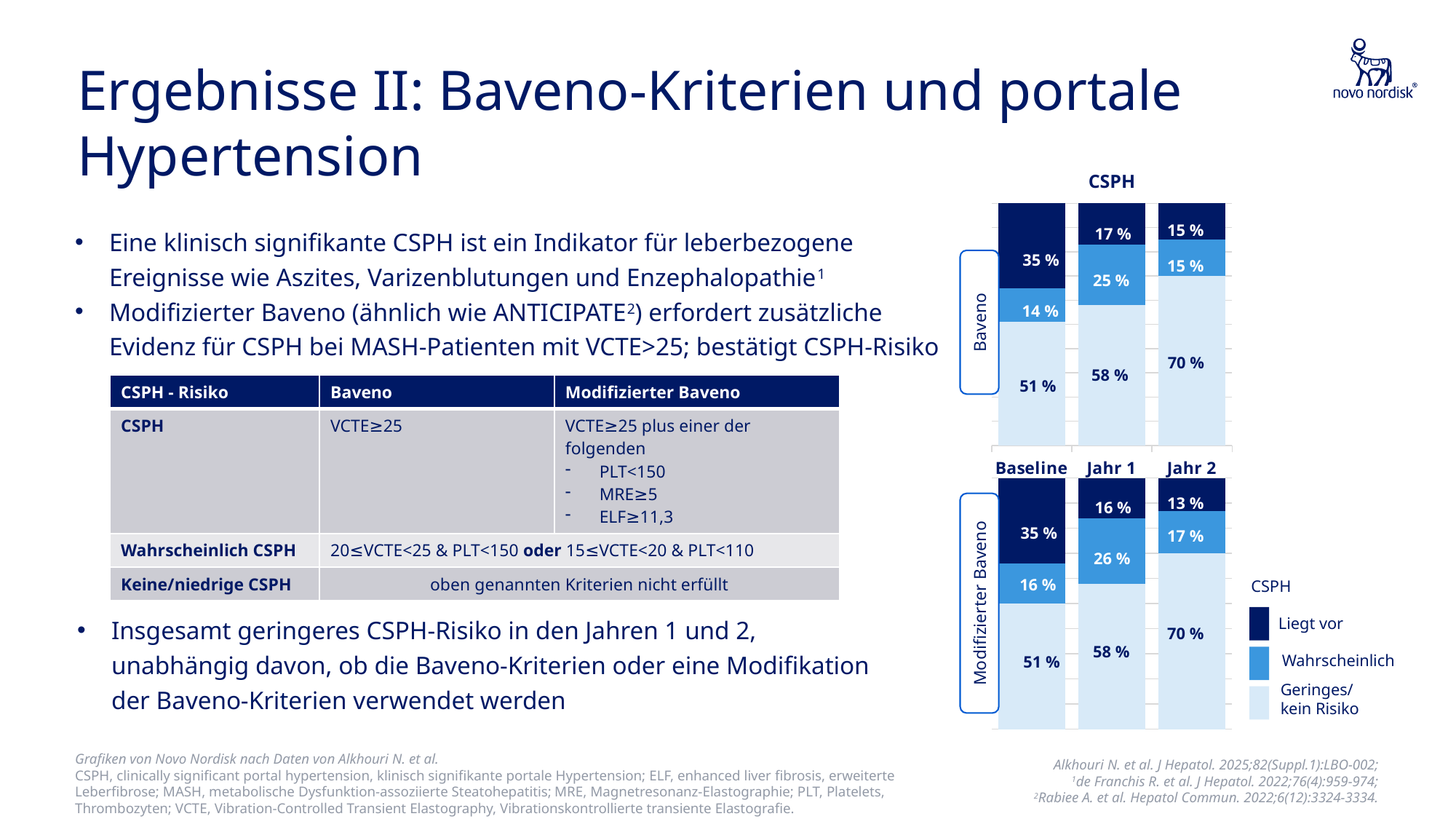
In the Modifizierter Baveno chart (bottom), what is the 'Liegt vor' value in Jahr 2? 13 % In the Modifizierter Baveno chart (bottom), which time point has the lowest 'Liegt vor' value? Jahr 2 In the Baveno chart (top), what is the 'Geringes/kein Risiko' value in Jahr 2? 70 % What type of chart is used to show the CSPH data? Stacked bar chart In the Modifizierter Baveno chart (bottom), is the 'Wahrscheinlich' value larger at Baseline or in Jahr 2? Jahr 2 In the Baveno chart (top), which time point has the highest 'Geringes/kein Risiko' value? Jahr 2 In the Baveno chart (top), what is the 'Liegt vor' value at Baseline? 35 % In the Baveno chart (top), what is the difference between the 'Liegt vor' value at Baseline and in Jahr 1? 18 % How many time points are shown in each chart? 3 In the Baveno chart (top), does the 'Liegt vor' value rise or fall from Baseline to Jahr 2? Fall In the Modifizierter Baveno chart (bottom), what is the 'Wahrscheinlich' value in Jahr 1? 26 % How many series does the CSPH legend list? 3